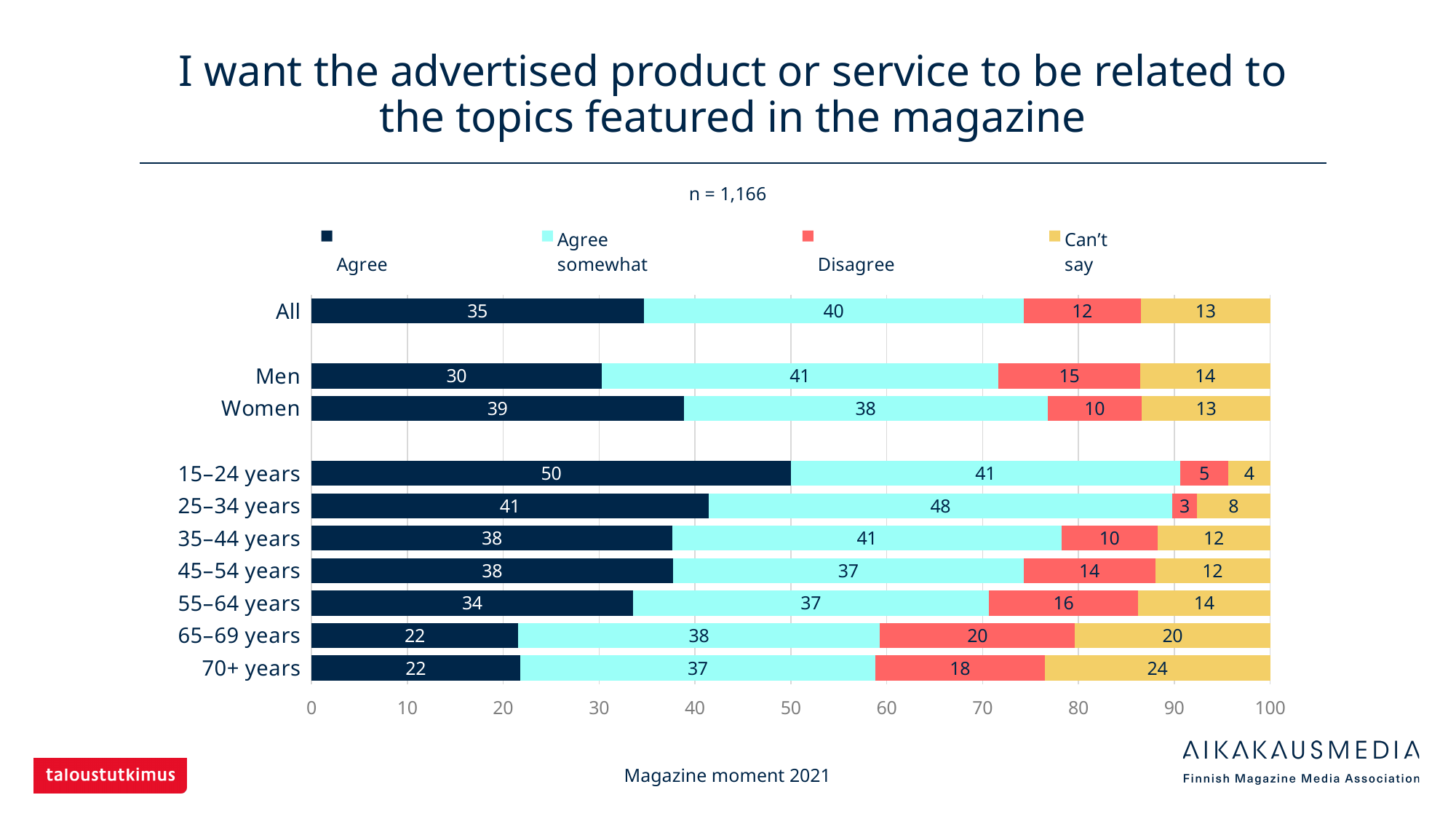
What sample size (n) is stated on the slide? n = 1,166 Which has a larger "Agree somewhat" value, 25–34 years or 35–44 years? 25–34 years How many series does the legend list? 4 Which category has the lowest "Disagree" value? 25–34 years What is the "Can't say" value for the 70+ years group? 24 What is the difference between the "Agree" values for Women and Men? 9 Which category has the highest "Agree" value? 15–24 years How many categories are shown on the y axis? 10 What kind of chart is shown on the slide? Stacked bar chart What is the "Agree" value for the 15–24 years group? 50 What is the "Disagree" value for Men? 15 What is the total of the stacked bar for the 65–69 years group? 100